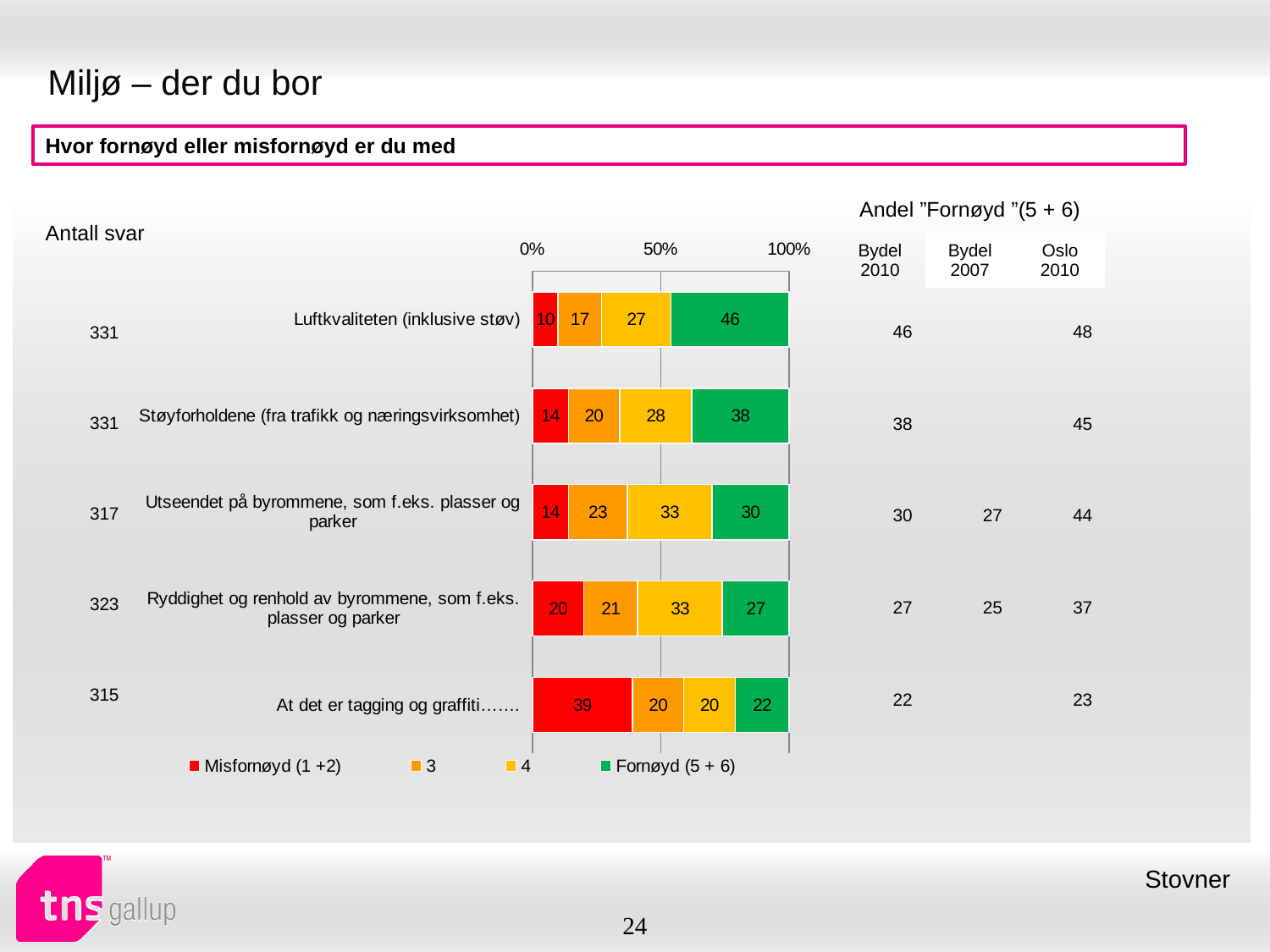
Which is larger: the "Misfornøyd (1 +2)" value for "Ryddighet og renhold av byrommene, som f.eks. plasser og parker" or for "Utseendet på byrommene, som f.eks. plasser og parker"? Ryddighet og renhold av byrommene, som f.eks. plasser og parker What is the difference between the "Fornøyd (5 + 6)" values for "Luftkvaliteten (inklusive støv)" and "At det er tagging og graffiti…"? 24 What is the value of series "4" for "Støyforholdene (fra trafikk og næringsvirksomhet)"? 28 Which category has the lowest "Misfornøyd (1 +2)" value? Luftkvaliteten (inklusive støv) Which category has the highest "Fornøyd (5 + 6)" value? Luftkvaliteten (inklusive støv) What is the value of "Misfornøyd (1 +2)" for "At det er tagging og graffiti…"? 39 How many series does the legend list? 4 Which colour represents the "Fornøyd (5 + 6)" series in the chart? green How many categories (statements) are plotted in the chart? 5 What is the value of "Fornøyd (5 + 6)" for "Luftkvaliteten (inklusive støv)"? 46 What is the total of the stacked bar for "Utseendet på byrommene, som f.eks. plasser og parker"? 100 What kind of chart is shown on the slide? stacked bar chart